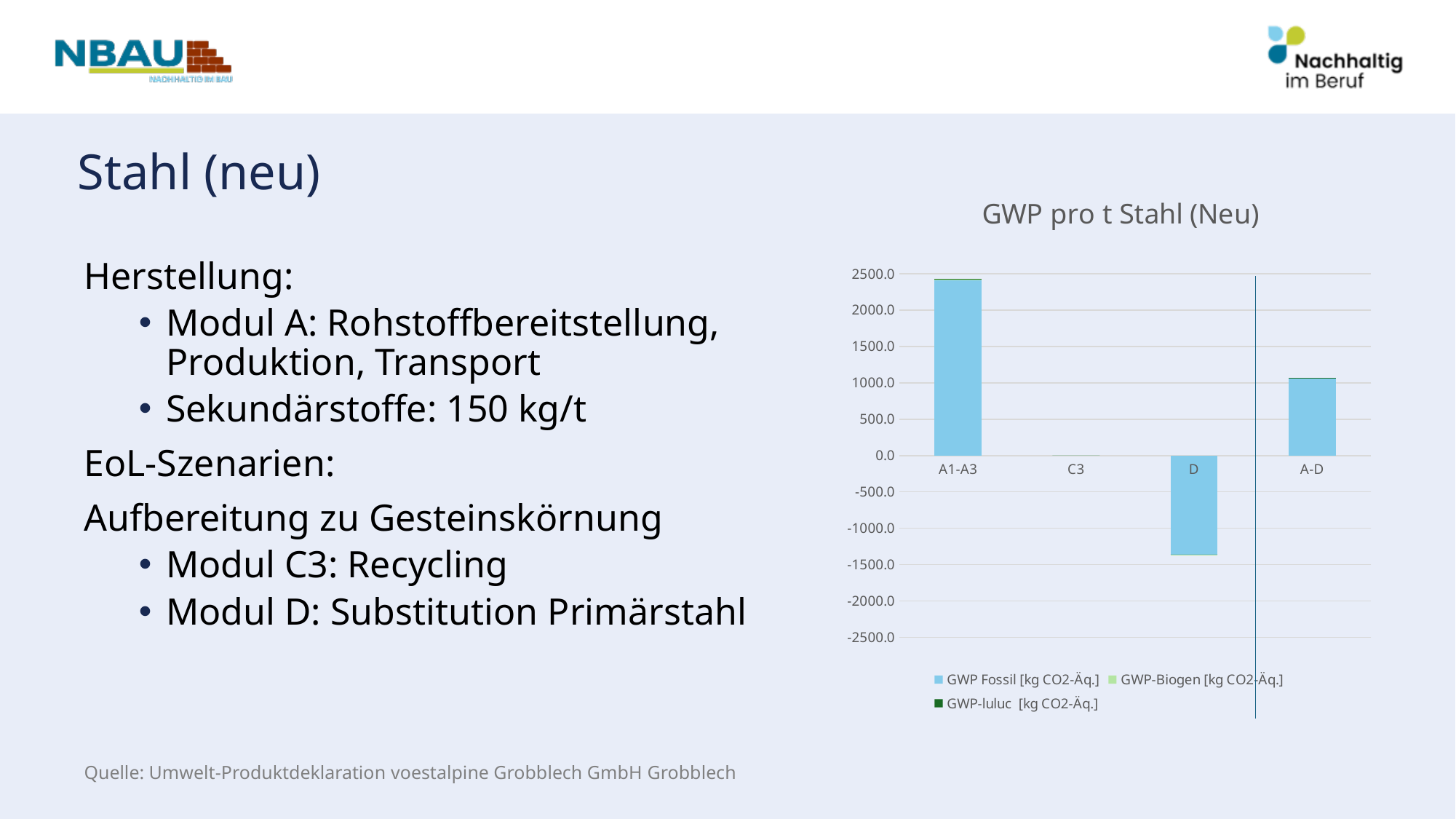
Which category has the lowest value in the chart? D How many categories are shown on the x axis of the chart? 4 Which is larger, the value for A1-A3 or the value for A-D? A1-A3 What kind of chart is shown on the slide? bar chart Is the value for A1-A3 greater or less than 2000.0? greater Is the value for D greater or less than -1000.0? less How many series does the chart's legend list? 3 Which series is shown in light blue in the chart's legend? GWP Fossil [kg CO2-Äq.] Is the value for D positive or negative? negative Which category has the highest value in the chart? A1-A3 What is the title of the chart on the slide? GWP pro t Stahl (Neu)